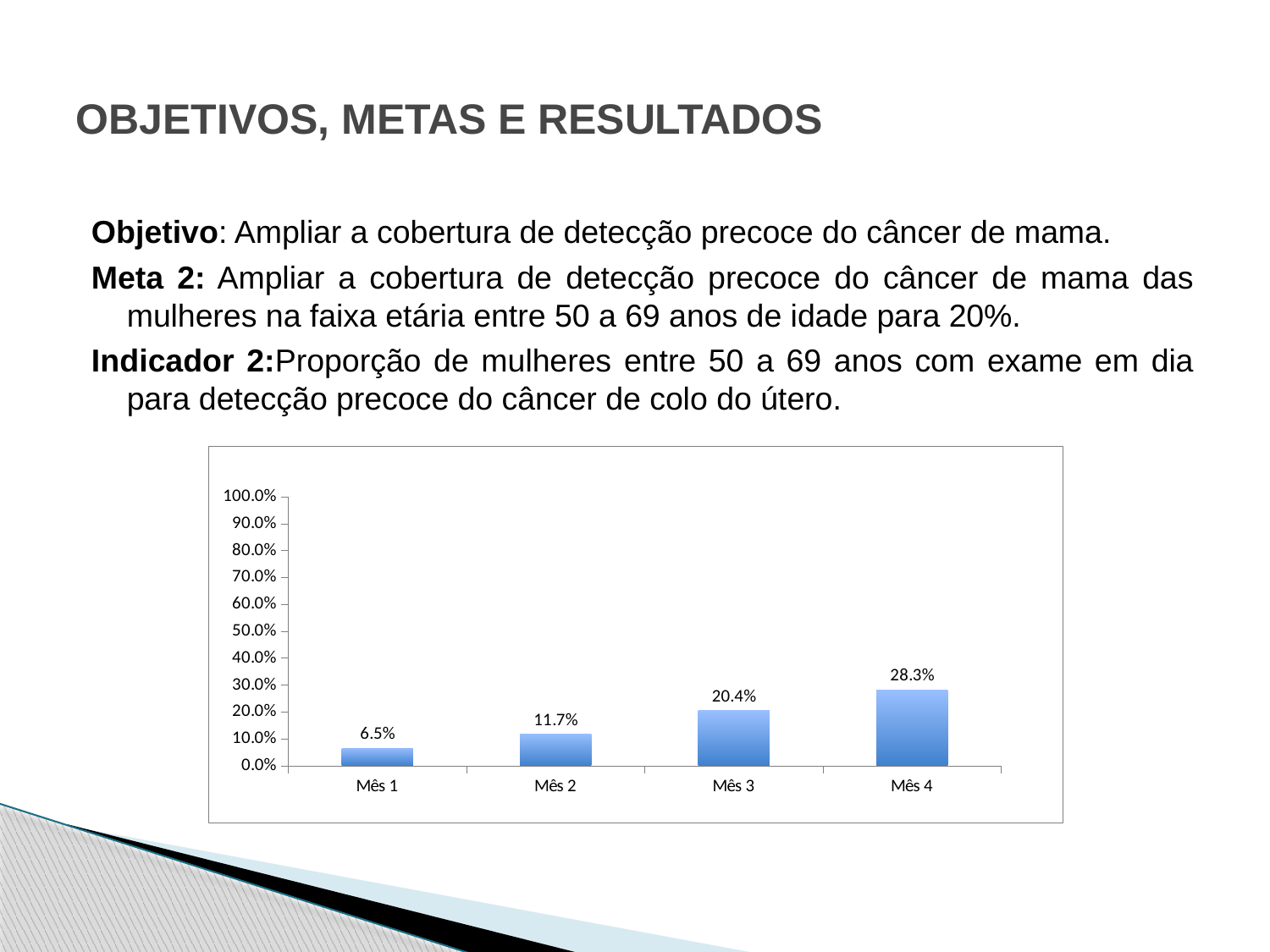
What is the difference between the values for Mês 4 and Mês 3? 7.9% Which month has the lowest value? Mês 1 What kind of chart is shown on the slide? bar chart Is the value for Mês 4 greater or less than 30.0%? less What is the value for Mês 4? 28.3% Which month has the highest value? Mês 4 Do the values rise or fall from Mês 1 to Mês 4? rise What is the value for Mês 1? 6.5% Which is larger, the value for Mês 2 or the value for Mês 3? Mês 3 What is the difference between the values for Mês 2 and Mês 1? 5.2% What is the value for Mês 3? 20.4% How many months are shown on the x axis? 4